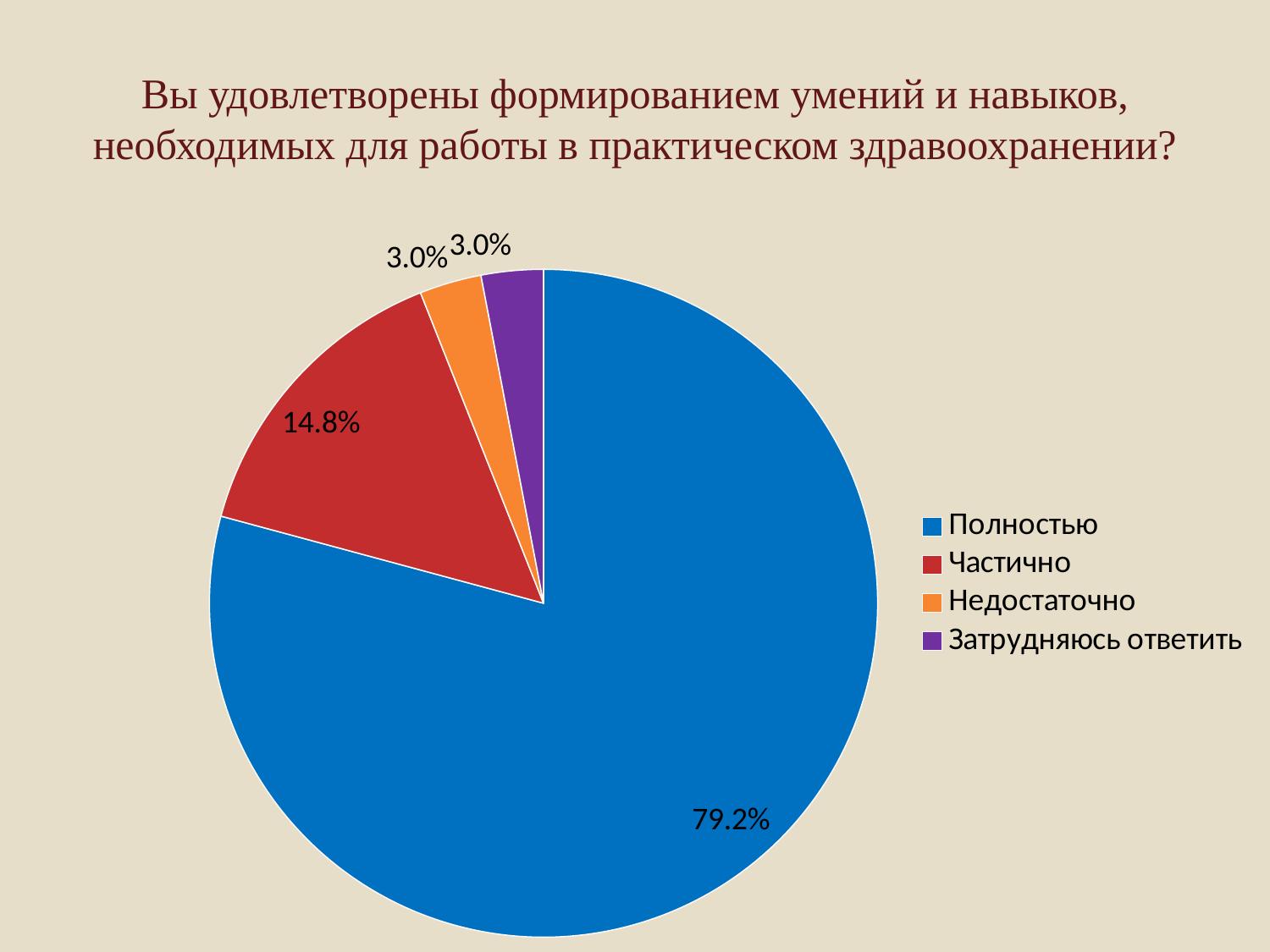
Which category has the largest slice of the pie? Полностью Which is larger, the value for "Частично" or the value for "Недостаточно"? Частично What is the value shown for "Частично"? 14.8% Is the value for "Полностью" greater or less than 50%? greater What is the difference between the values for "Полностью" and "Частично"? 64.4% How many categories does the legend list? 4 What is the value shown for "Затрудняюсь ответить"? 3.0% What share of the pie does the "Полностью" slice represent? 79.2% What colour is the "Полностью" slice? blue What kind of chart is shown on the slide? pie chart Which category is shown in purple in the legend? Затрудняюсь ответить What is the value shown for "Недостаточно"? 3.0%